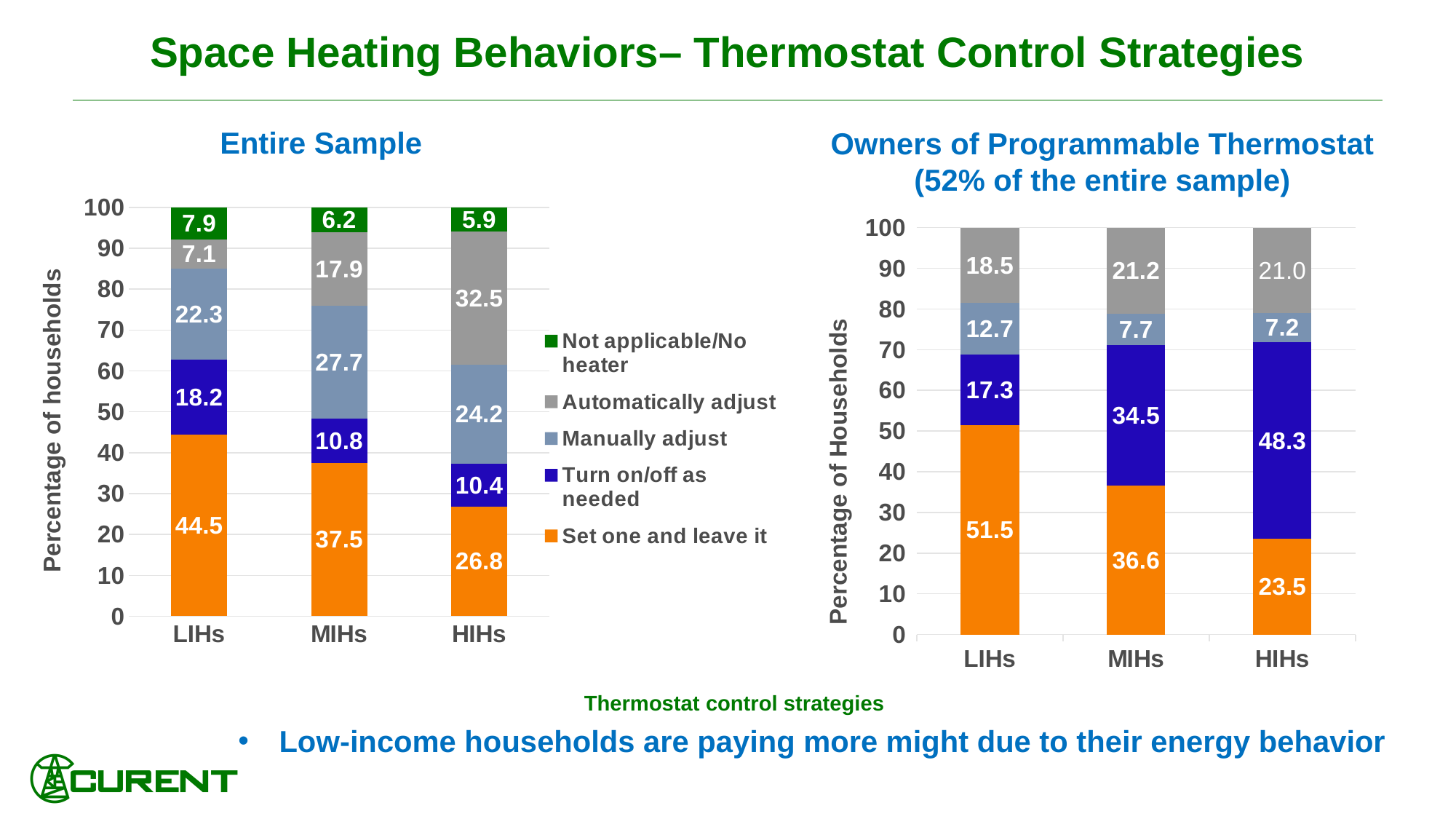
In the Entire Sample chart, does the Set one and leave it value rise or fall from LIHs to HIHs? Fall In the Owners of Programmable Thermostat chart, what is the difference between the Turn on/off as needed values for HIHs and LIHs? 31.0 What kind of chart is the Entire Sample chart? Stacked bar chart What is the y-axis label of the Owners of Programmable Thermostat chart? Percentage of Households In the Entire Sample chart, which category has the highest value for Automatically adjust? HIHs In the Entire Sample chart, what is the value for Set one and leave it for LIHs? 44.5 In the Owners of Programmable Thermostat chart, which category has the lowest value for Set one and leave it? HIHs In the Owners of Programmable Thermostat chart, which is larger for Manually adjust: LIHs or MIHs? LIHs How many categories are shown on the x axis of the Entire Sample chart? 3 In the Entire Sample chart, what is the difference between the Set one and leave it values for LIHs and HIHs? 17.7 In the Owners of Programmable Thermostat chart, what is the value for Turn on/off as needed for HIHs? 48.3 How many series does the legend on the slide list? 5